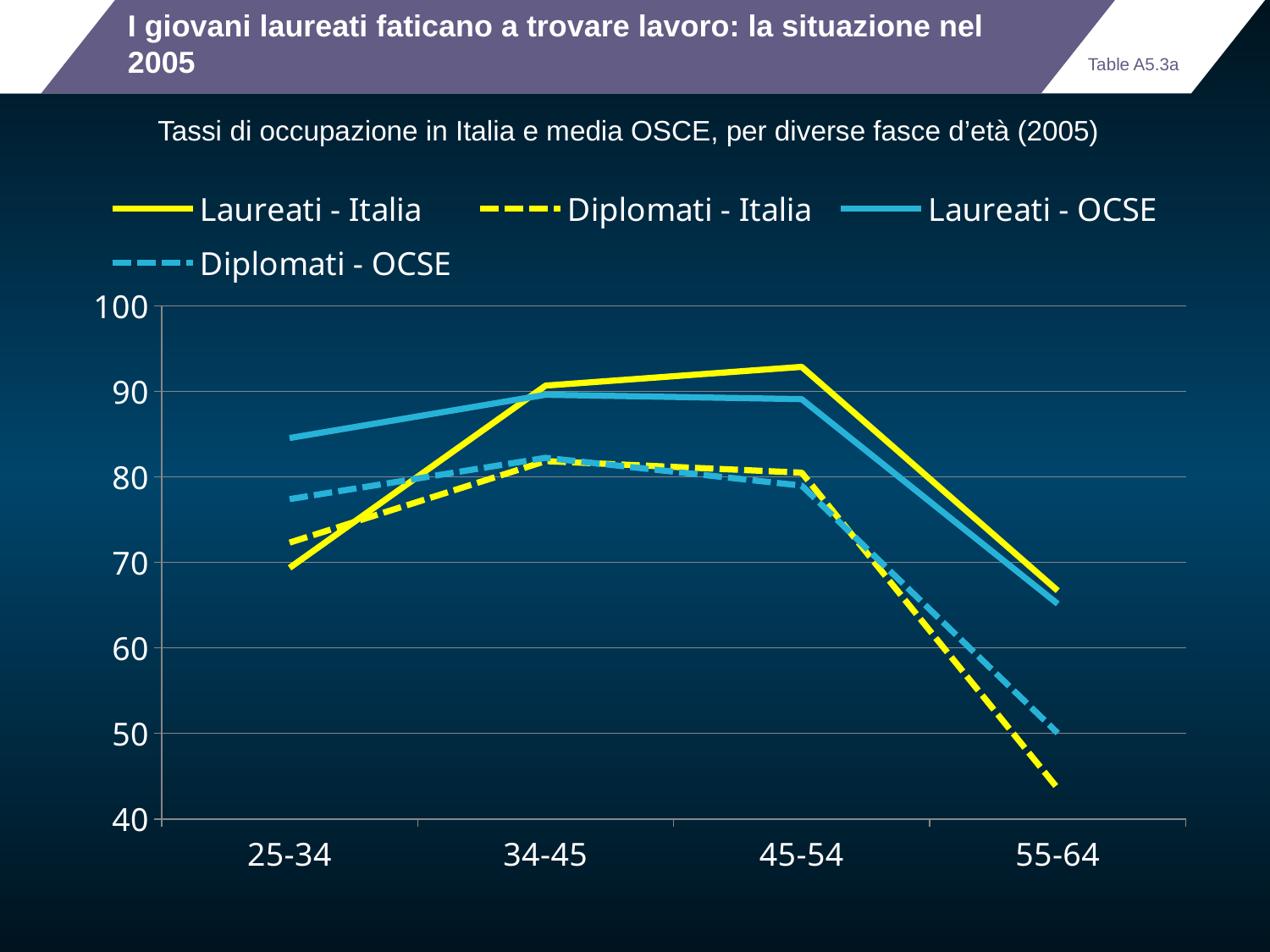
In which age group does the Laureati - Italia series reach its highest value? 45-54 Does the Laureati - OCSE series rise or fall from the 45-54 age group to the 55-64 age group? fall Which series has the lowest value in the 55-64 age group? Diplomati - Italia Is the value for Laureati - OCSE in the 25-34 age group greater or less than 80? greater What kind of chart is shown on the slide? line chart In the 55-64 age group, which is larger: Diplomati - Italia or Diplomati - OCSE? Diplomati - OCSE In the 25-34 age group, which is larger: Laureati - Italia or Laureati - OCSE? Laureati - OCSE How many series does the legend list? 4 Is the value for Laureati - Italia in the 45-54 age group greater or less than 90? greater Is the value for Diplomati - Italia in the 55-64 age group greater or less than 50? less How many age groups are shown on the x axis? 4